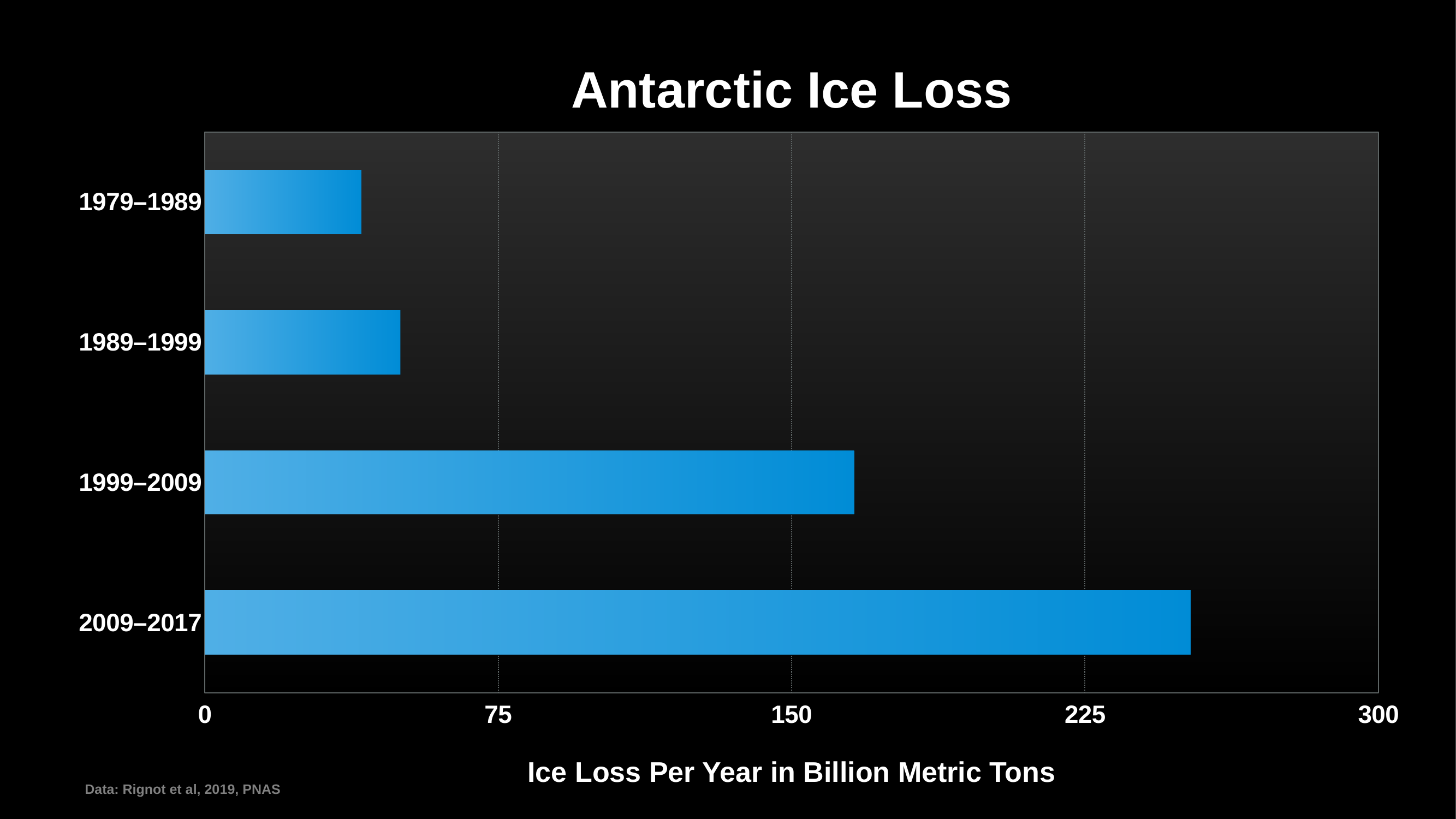
What is the label on the horizontal axis of the chart? Ice Loss Per Year in Billion Metric Tons Which period has the lowest ice loss per year? 1979–1989 Is the value for 2009–2017 greater or less than 225? greater How many time periods are plotted in the chart? 4 What kind of chart is shown on the slide? bar chart Is the value for 1979–1989 greater or less than 75? less Is the value for 1989–1999 greater or less than 75? less Which period has the highest ice loss per year? 2009–2017 Which is larger, the value for 1989–1999 or the value for 1999–2009? 1999–2009 What is the title of the chart? Antarctic Ice Loss Do the values rise or fall as the periods move from 1979–1989 to 2009–2017? rise